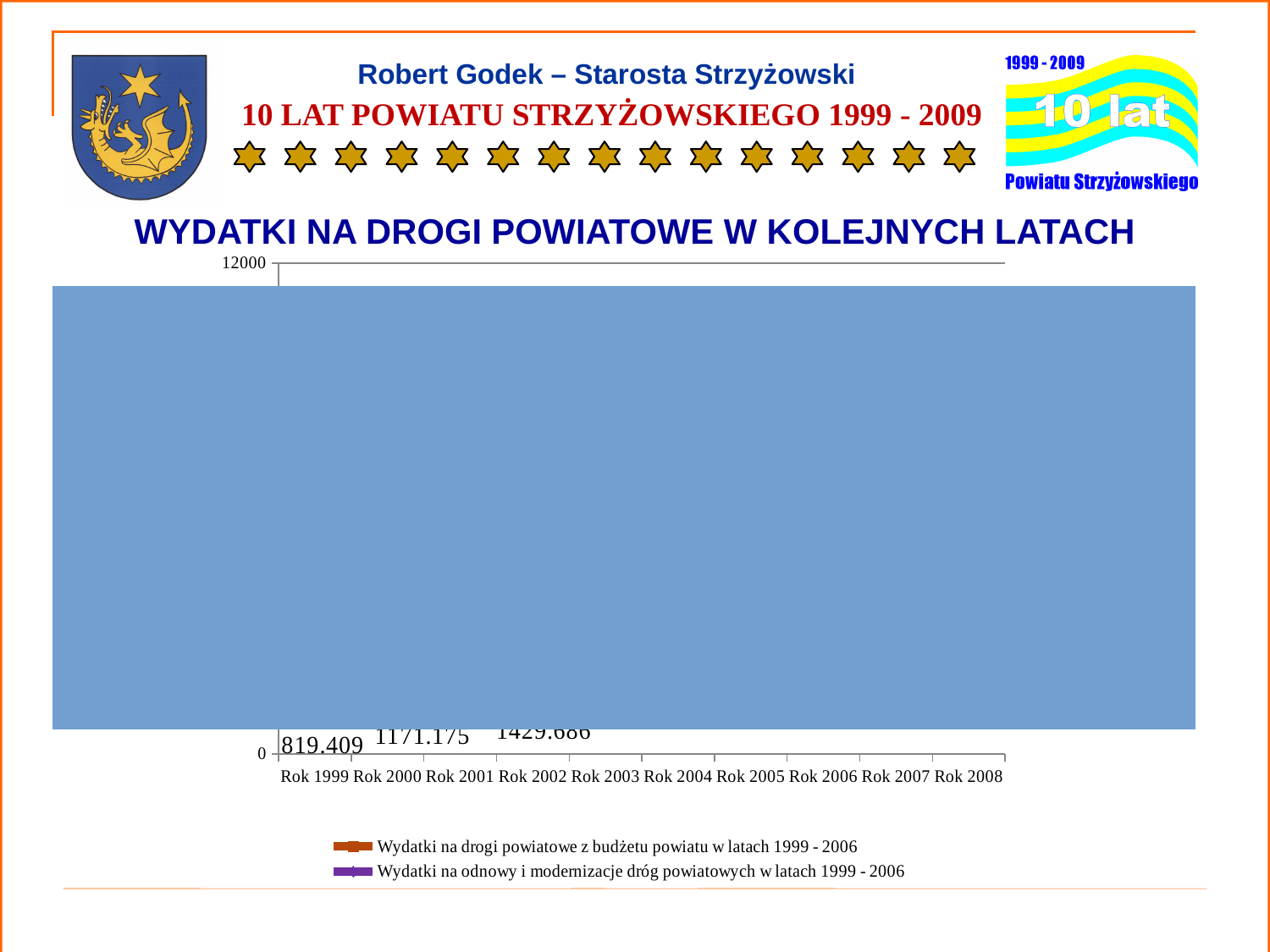
How many years (categories) are shown on the x axis? 10 What is the first category on the x axis? Rok 1999 Is the value for Rok 1999 greater or less than 12000? less What is the highest value shown on the y axis? 12000 How many series does the legend list? 2 What is the title of the chart? WYDATKI NA DROGI POWIATOWE W KOLEJNYCH LATACH What is the last category on the x axis? Rok 2008 What is the data label shown for Rok 1999? 819.409